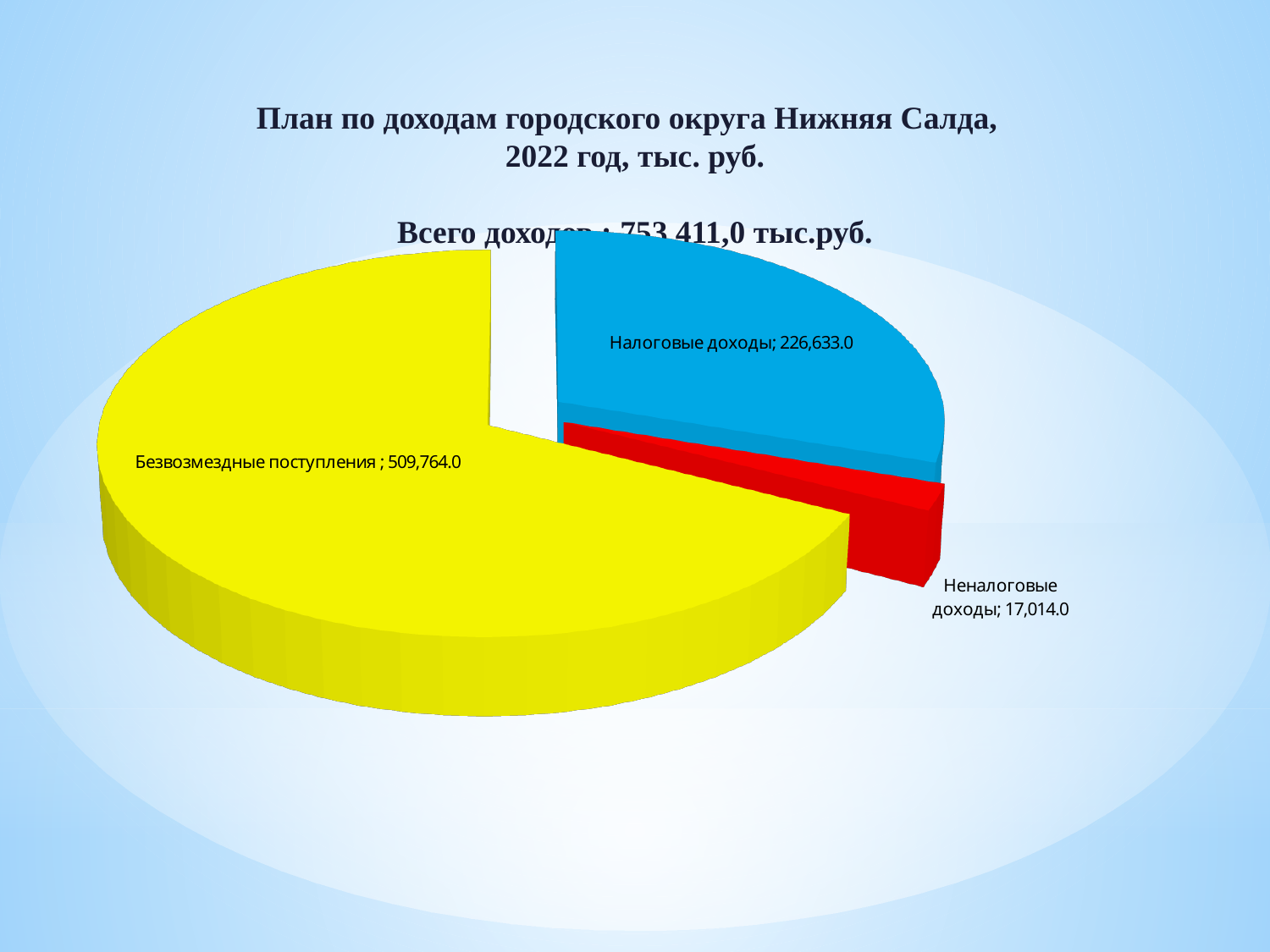
What kind of chart is shown on the slide? Pie chart Which category has the smallest slice of the pie? Неналоговые доходы What colour is the slice for Неналоговые доходы? Red What is the difference between Налоговые доходы and Неналоговые доходы? 209,619.0 Which is larger, Налоговые доходы or Неналоговые доходы? Налоговые доходы How many categories are shown in the pie chart? 3 Which category has the largest slice of the pie? Безвозмездные поступления What is the difference between Безвозмездные поступления and Налоговые доходы? 283,131.0 What is the total of all three slices of the pie? 753,411.0 What is the value for Неналоговые доходы? 17,014.0 What is the value for Налоговые доходы? 226,633.0 What is the value for Безвозмездные поступления? 509,764.0